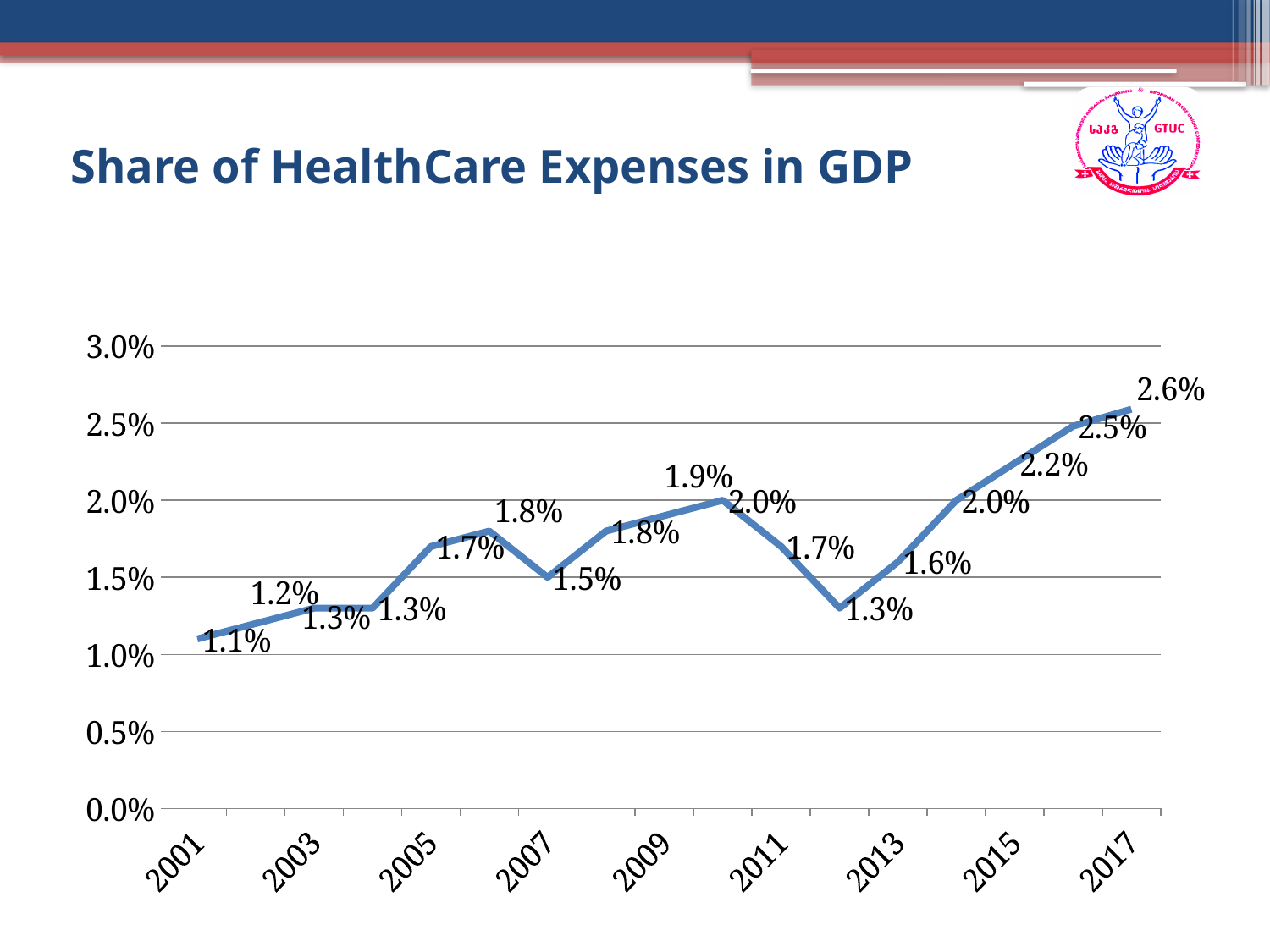
What value is shown for 2009? 1.9% Which year has the larger value, 2009 or 2013? 2009 What kind of chart is shown on the slide? Line chart By how many percentage points did the share rise from 2001 to 2017? 1.5 percentage points Which year has the highest share of healthcare expenses in GDP? 2017 What is the title of the chart? Share of HealthCare Expenses in GDP Which year has the lowest share of healthcare expenses in GDP? 2001 Is the value for 2001 greater or less than 1.5%? less What is the share of healthcare expenses in GDP in 2001? 1.1% What is the share of healthcare expenses in GDP in 2017? 2.6% What value is shown for 2015? 2.2% What value is shown for 2013? 1.6%